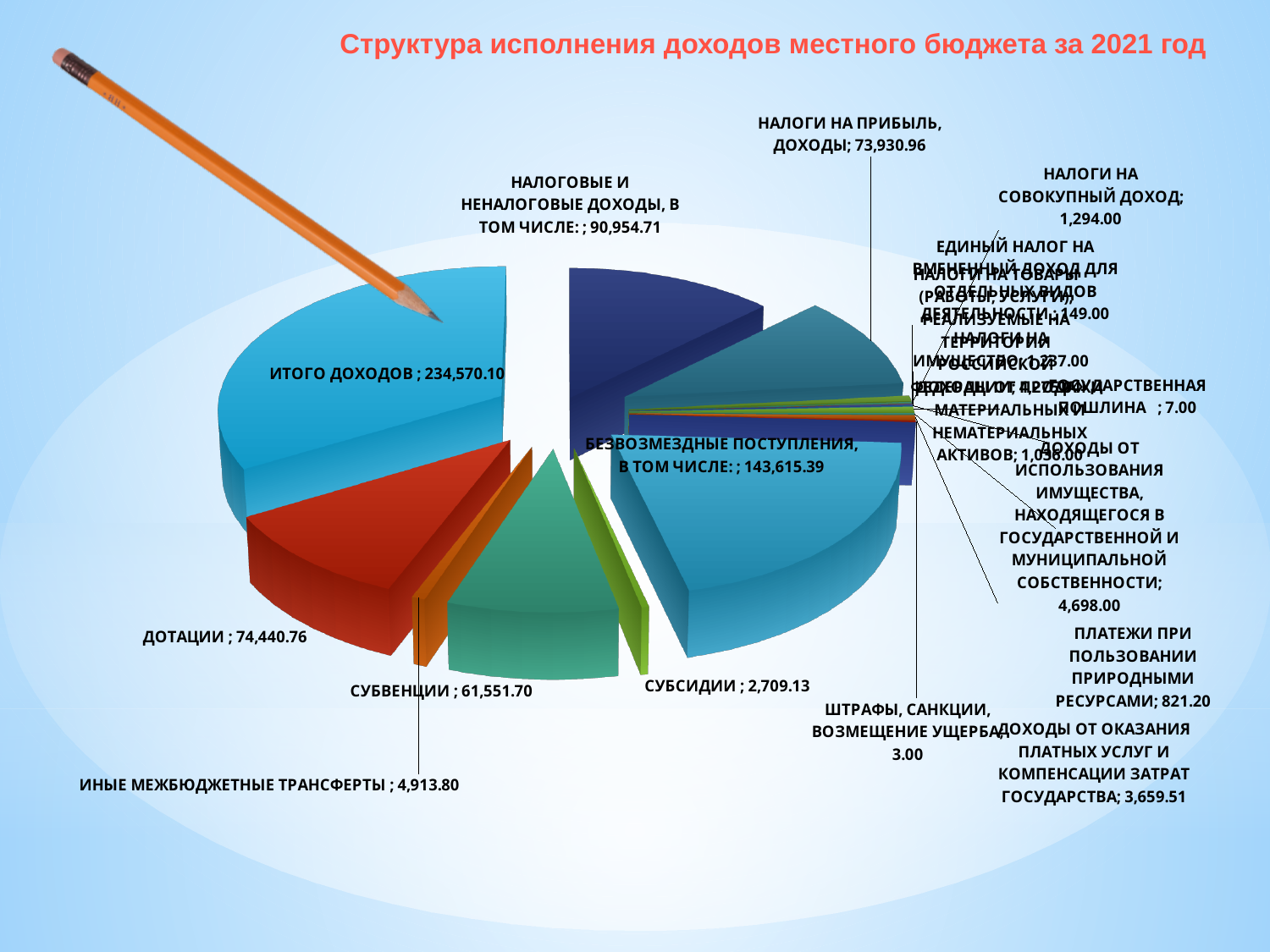
What is the value shown for ИНЫЕ МЕЖБЮДЖЕТНЫЕ ТРАНСФЕРТЫ? 4,913.80 What is the value shown for ДОТАЦИИ? 74,440.76 What is the difference between the values for ДОТАЦИИ and СУБВЕНЦИИ? 12,889.06 What kind of chart is shown on the slide? Pie chart What is the value shown for ИТОГО ДОХОДОВ? 234,570.10 Which category has the largest slice in the pie chart? ИТОГО ДОХОДОВ What is the value shown for БЕЗВОЗМЕЗДНЫЕ ПОСТУПЛЕНИЯ, В ТОМ ЧИСЛЕ:? 143,615.39 What is the value shown for ГОСУДАРСТВЕННАЯ ПОШЛИНА? 7.00 What is the title of the chart? Структура исполнения доходов местного бюджета за 2021 год What is the value shown for СУБВЕНЦИИ? 61,551.70 What is the value shown for НАЛОГИ НА ПРИБЫЛЬ, ДОХОДЫ? 73,930.96 Which is larger, ДОТАЦИИ or СУБВЕНЦИИ? ДОТАЦИИ